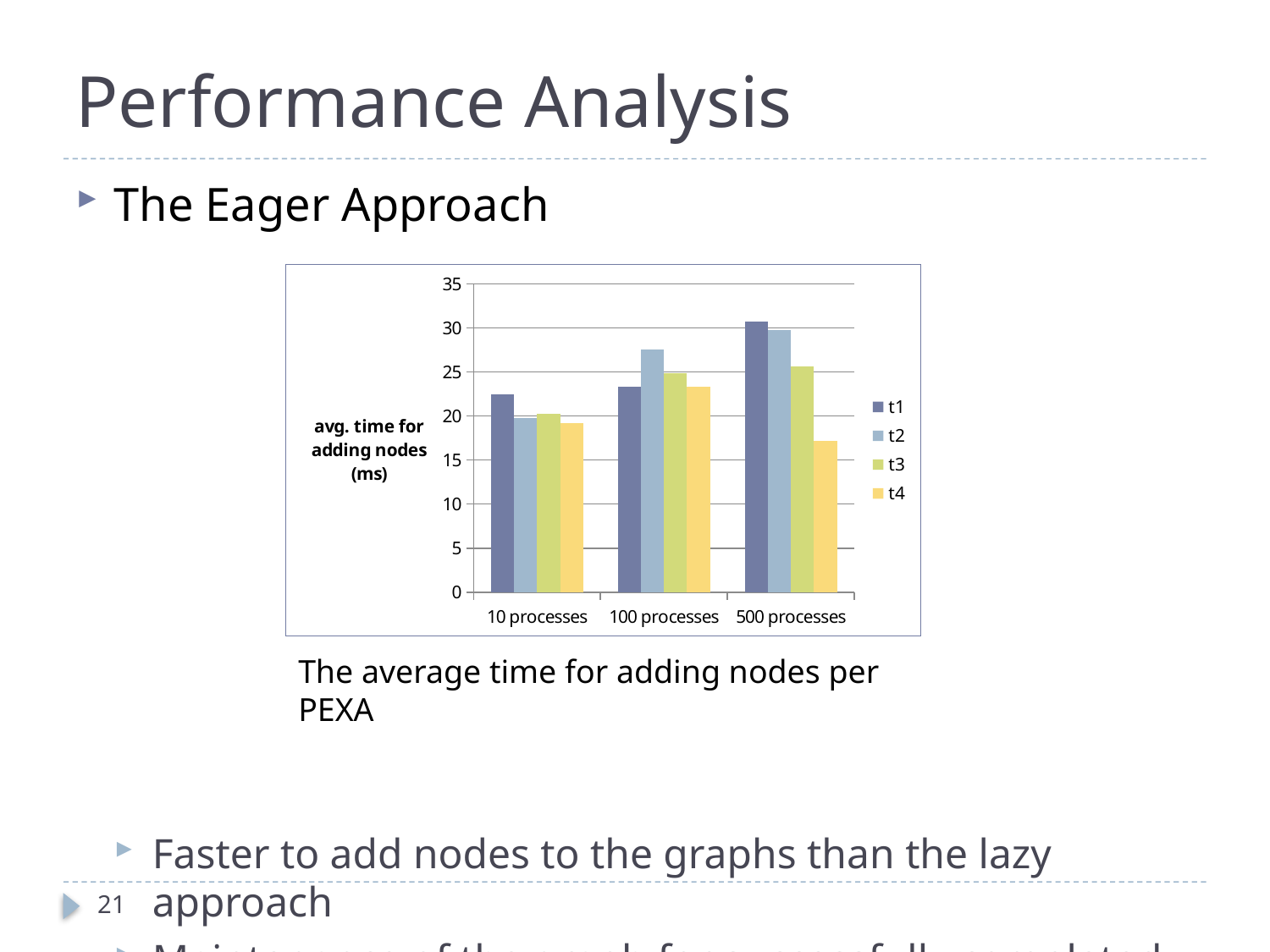
Which series has the highest value for 100 processes? t2 Is the value for t1 at 100 processes greater or less than 25? less Which series has the lowest value for 500 processes? t4 What is the label on the vertical axis of the chart? avg. time for adding nodes (ms) Is the value for t1 at 10 processes greater or less than 20? greater Does the value for t1 rise or fall as the number of processes increases from 10 to 500? rise What kind of chart is shown on the slide? bar chart How many series does the legend list? 4 For 500 processes, which is larger, t3 or t4? t3 Is the value for t2 at 100 processes greater or less than 25? greater How many process-count categories are shown on the x axis? 3